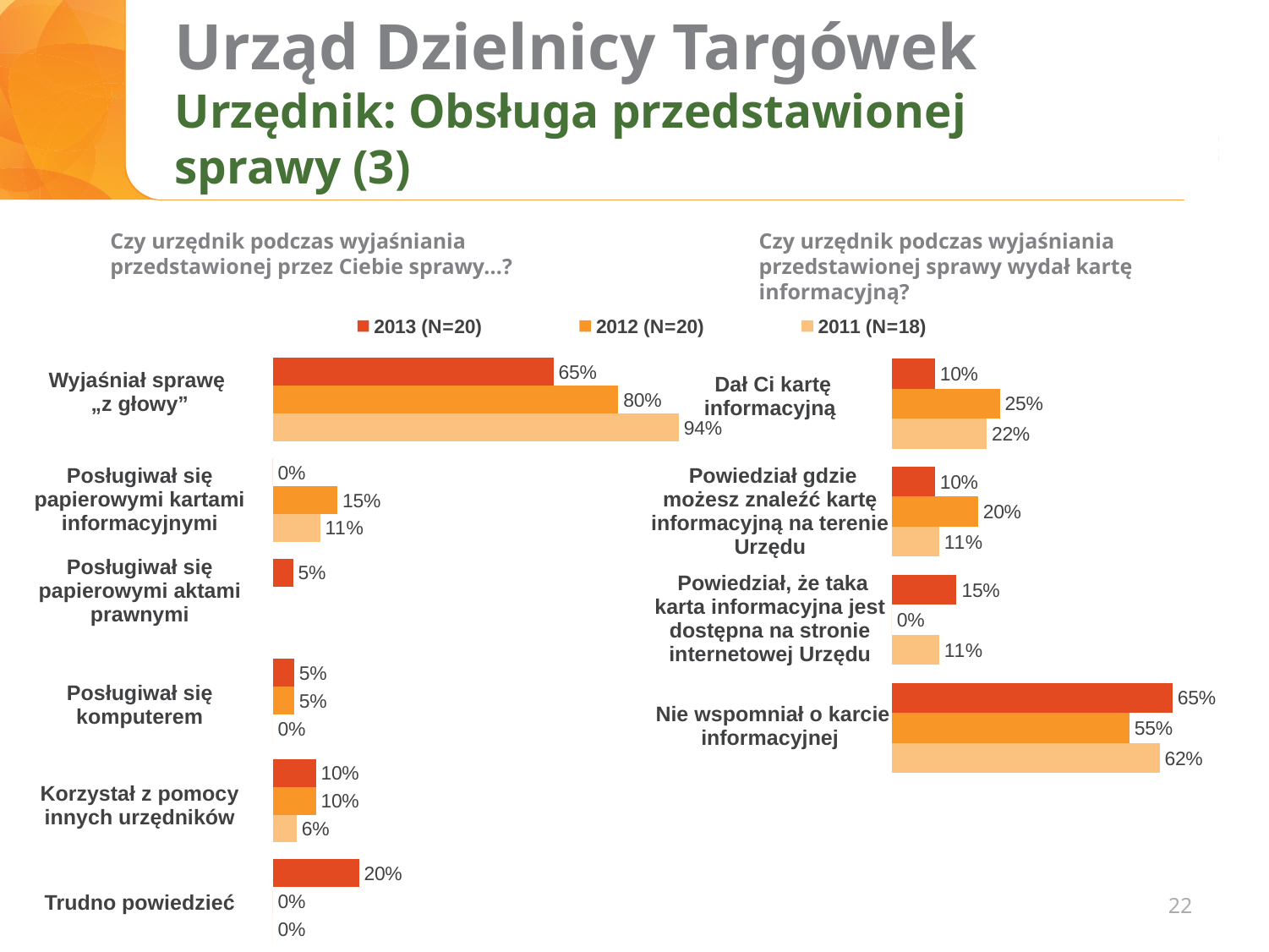
In the left chart, which category has the highest 2012 (N=20) value? Wyjaśniał sprawę „z głowy” In the right chart, which is larger for "Powiedział gdzie możesz znaleźć kartę informacyjną na terenie Urzędu": the 2012 (N=20) value or the 2011 (N=18) value? 2012 (N=20) How many series does the legend list? 3 In the right chart, which category has the lowest 2013 (N=20) value? Dał Ci kartę informacyjną and Powiedział gdzie możesz znaleźć kartę informacyjną na terenie Urzędu (both 10%) In the right chart ("Czy urzędnik podczas wyjaśniania przedstawionej sprawy wydał kartę informacyjną?"), what is the 2012 (N=20) value for "Dał Ci kartę informacyjną"? 25% In the right chart, what is the 2011 (N=18) value for "Nie wspomniał o karcie informacyjnej"? 62% How many categories does the right chart show? 4 In the left chart, what is the 2013 (N=20) value for "Trudno powiedzieć"? 20% In the left chart, what is the difference between the 2011 (N=18) and 2013 (N=20) values for "Wyjaśniał sprawę „z głowy”"? 29 percentage points What kind of chart is the left chart? Bar chart In the left chart ("Czy urzędnik podczas wyjaśniania przedstawionej przez Ciebie sprawy...?"), what is the 2011 (N=18) value for "Wyjaśniał sprawę „z głowy”"? 94% In the right chart, what is the difference between the 2013 (N=20) and 2012 (N=20) values for "Nie wspomniał o karcie informacyjnej"? 10 percentage points